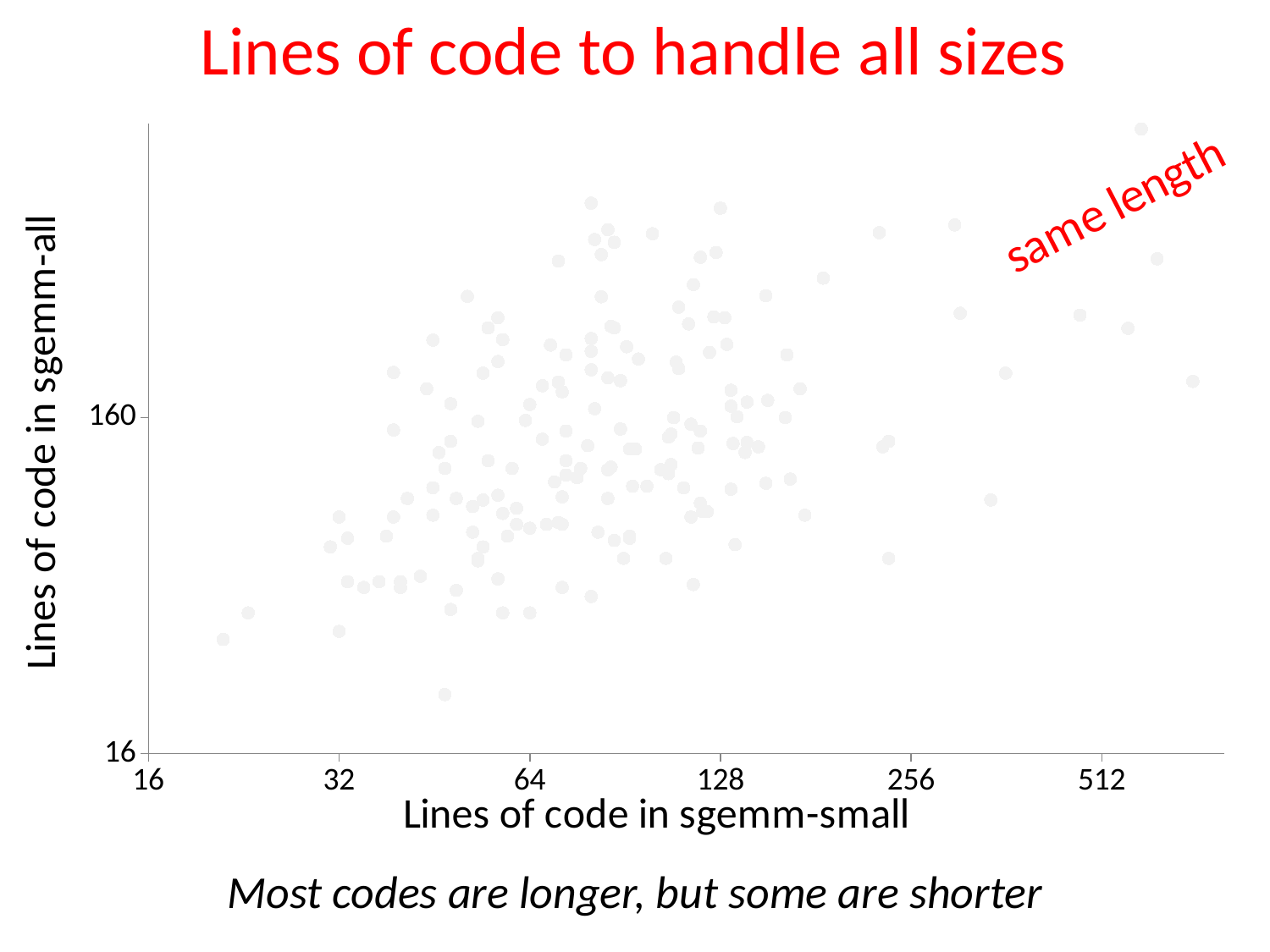
What kind of chart is shown on the slide? scatter plot What is the title of the chart? Lines of code to handle all sizes Do the values for lines of code in sgemm-all generally rise or fall as lines of code in sgemm-small increase along the x axis? rise What is the label of the x axis? Lines of code in sgemm-small